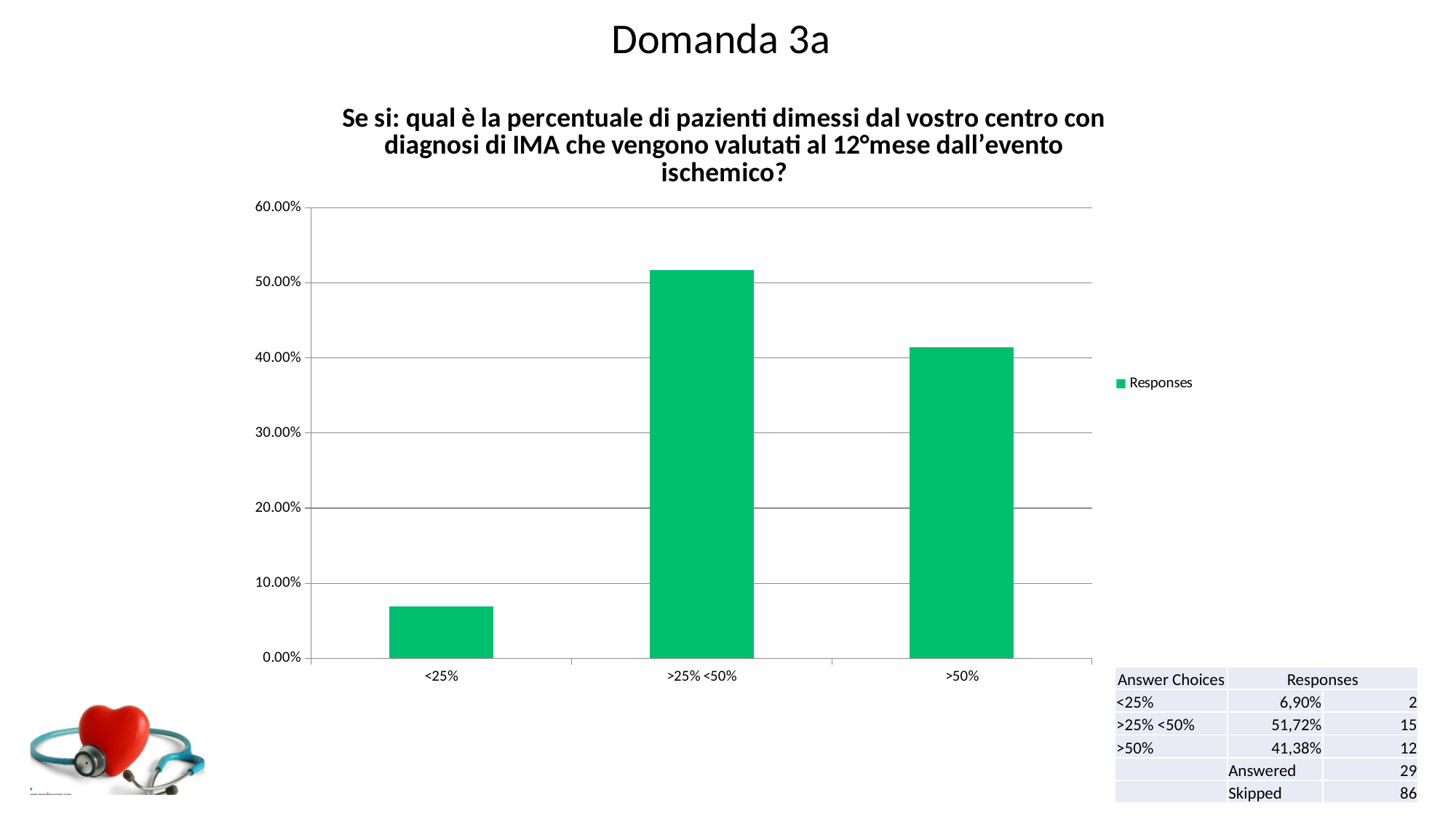
According to the table on the slide, what is the response percentage for the category <25%? 6,90% According to the table on the slide, what is the response percentage for the category >50%? 41,38% What is the name of the series shown in the chart legend? Responses Which category has the lowest bar in the chart? <25% How many categories are shown on the x axis of the chart? 3 Which is larger, the value for >25% <50% or the value for >50%? >25% <50% Is the value for <25% greater or less than 10.00%? less Which category has the highest bar in the chart? >25% <50% According to the table on the slide, what is the response percentage for the category >25% <50%? 51,72% How many series does the chart legend list? 1 Is the value for >50% greater or less than 40.00%? greater What kind of chart is shown on the slide? bar chart